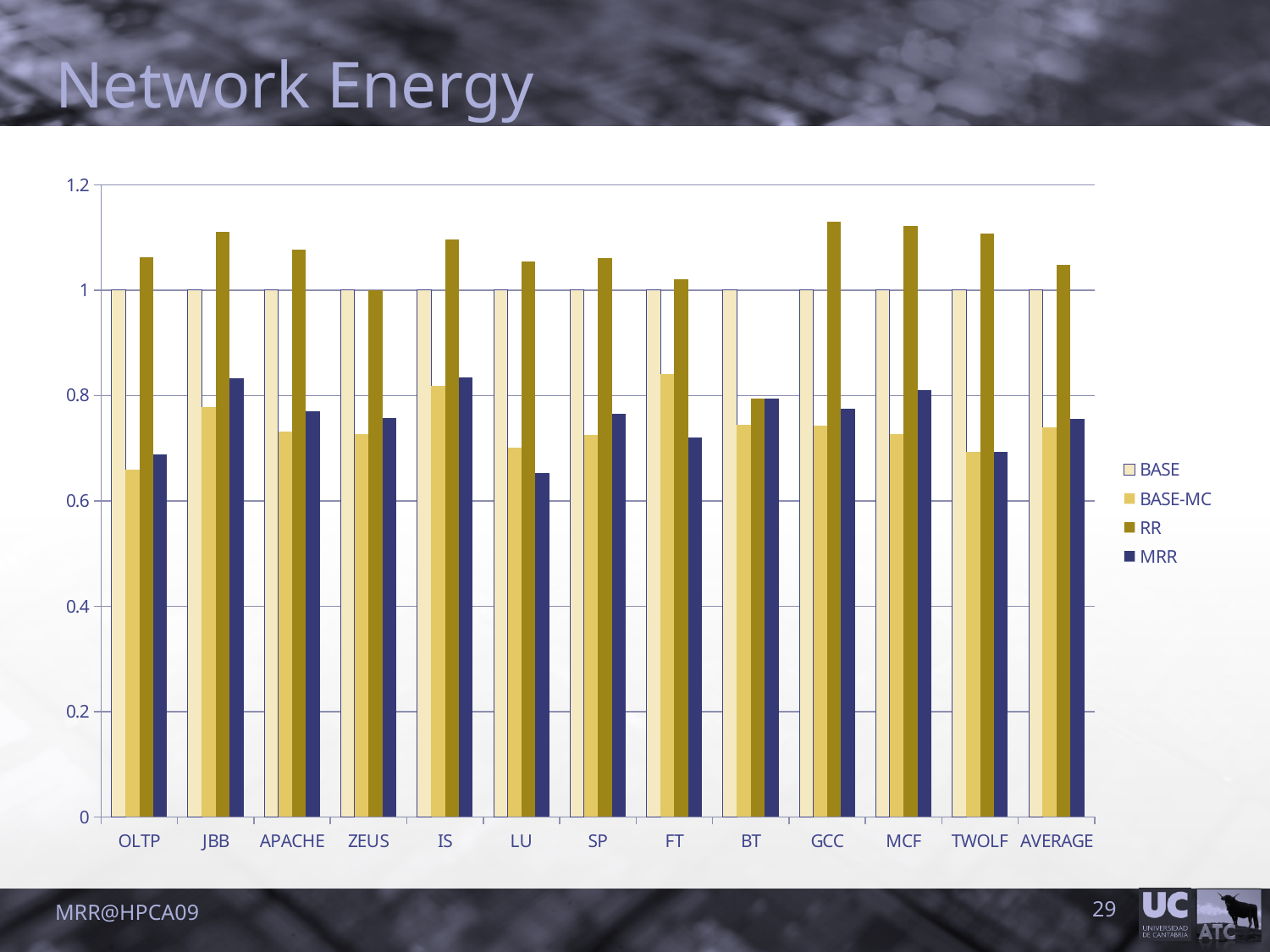
For OLTP, which is larger: the RR value or the MRR value? RR Is the BASE-MC value for FT greater or less than 0.8? greater How many categories are shown along the x axis? 13 Which category has the lowest RR value? BT How many series does the legend list? 4 Is the MRR value for LU greater or less than 0.7? less What is the RR value for ZEUS? 1 What is the title of the chart? Network Energy Is the RR value for OLTP greater or less than 1? greater What kind of chart is shown on the slide? bar chart Which category has the lowest MRR value? LU What is the BASE value for OLTP? 1